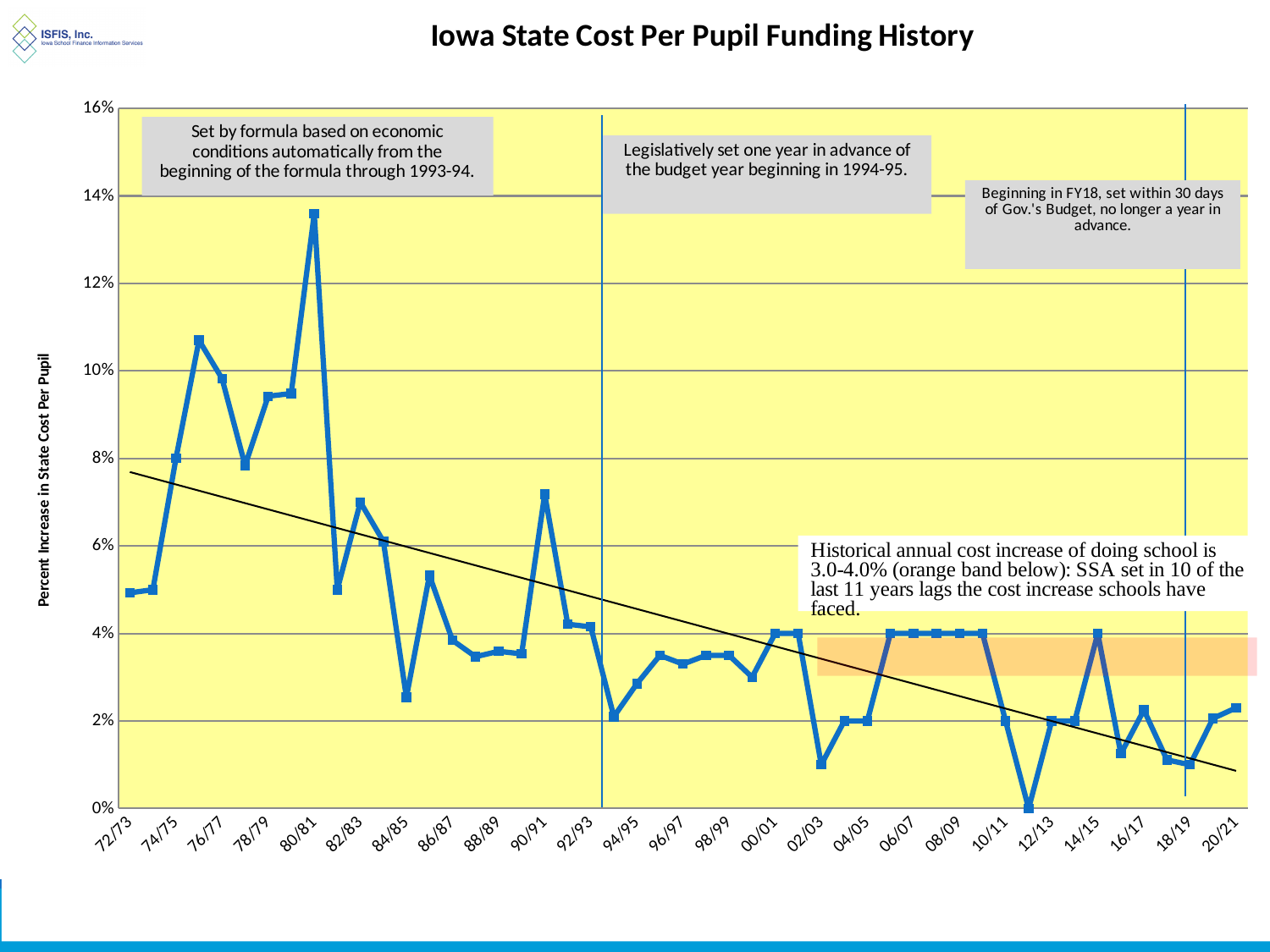
What is the title of the chart? Iowa State Cost Per Pupil Funding History What is the percent increase in state cost per pupil for 00/01? 4% What kind of chart is shown on the slide? line chart What is the percent increase in state cost per pupil for 74/75? 8% What is the percent increase in state cost per pupil for 10/11? 2% Which year has the highest percent increase in state cost per pupil? 80/81 Is the value for 80/81 greater or less than 12%? greater What is the percent increase in state cost per pupil for 14/15? 4% What is the label on the vertical axis of the chart? Percent Increase in State Cost Per Pupil Overall, do the percent increases rise or fall from 72/73 to 20/21? fall Is the value for 84/85 greater or less than 4%? less Which year has the larger percent increase, 80/81 or 90/91? 80/81